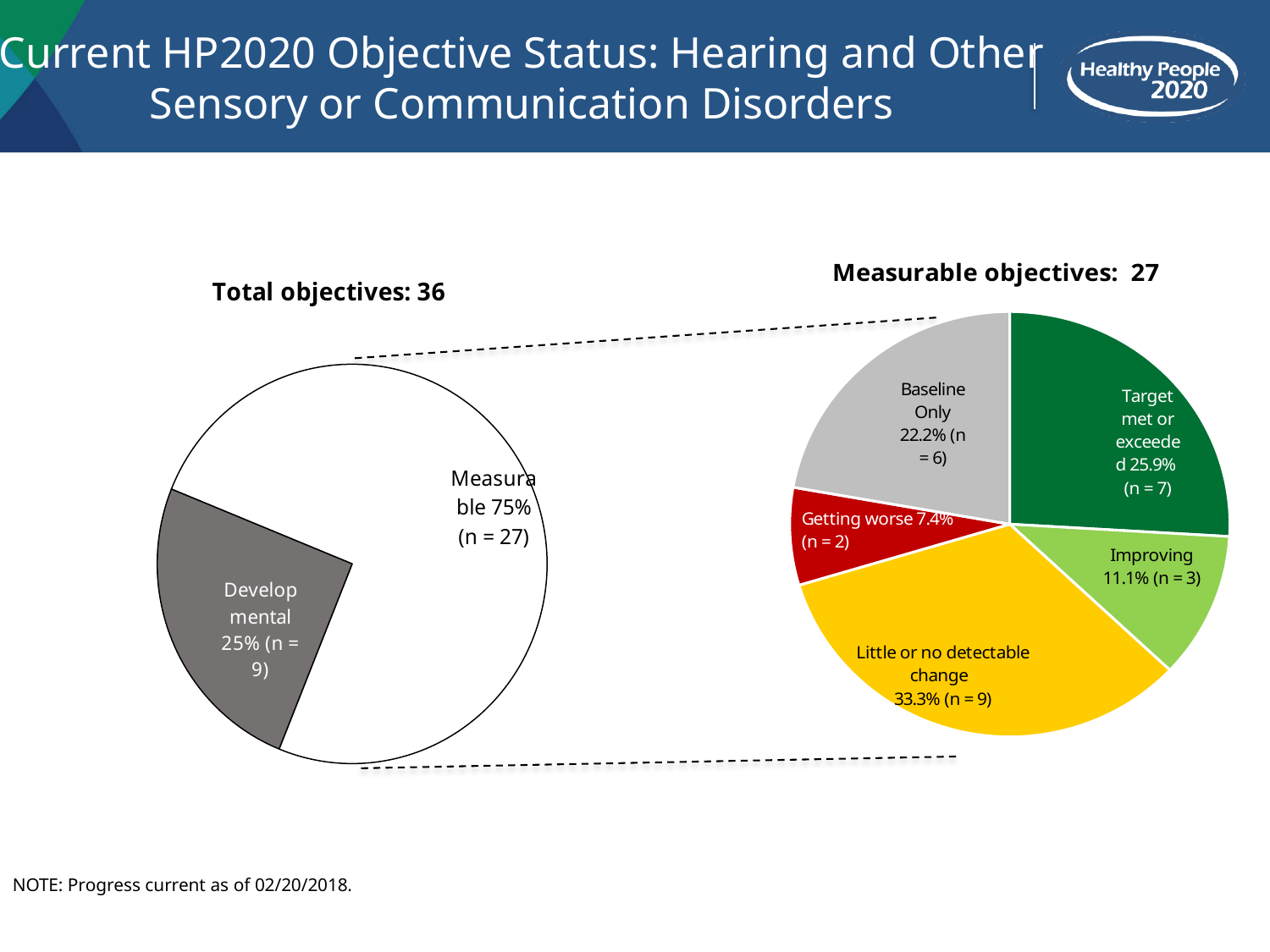
In the 'Measurable objectives: 27' chart on the right, how many more objectives are Baseline Only than Improving? 3 What kind of chart is the 'Total objectives: 36' chart on the left? Pie chart In the 'Measurable objectives: 27' chart on the right, what is the percentage for Improving? 11.1% In the 'Measurable objectives: 27' chart on the right, how many objectives are Getting worse? 2 In the 'Total objectives: 36' chart on the left, how many objectives are Developmental? 9 How many categories does the 'Measurable objectives: 27' chart on the right show? 5 In the 'Measurable objectives: 27' chart on the right, which category has the largest share? Little or no detectable change In the 'Measurable objectives: 27' chart on the right, what percentage of objectives have Target met or exceeded? 25.9% In the 'Total objectives: 36' chart on the left, what share of objectives is Measurable? 75% In the 'Measurable objectives: 27' chart on the right, which category has the smallest share? Getting worse In the 'Measurable objectives: 27' chart on the right, what colour is the Little or no detectable change slice? Yellow In the 'Measurable objectives: 27' chart on the right, which is larger: the share for Baseline Only or the share for Improving? Baseline Only